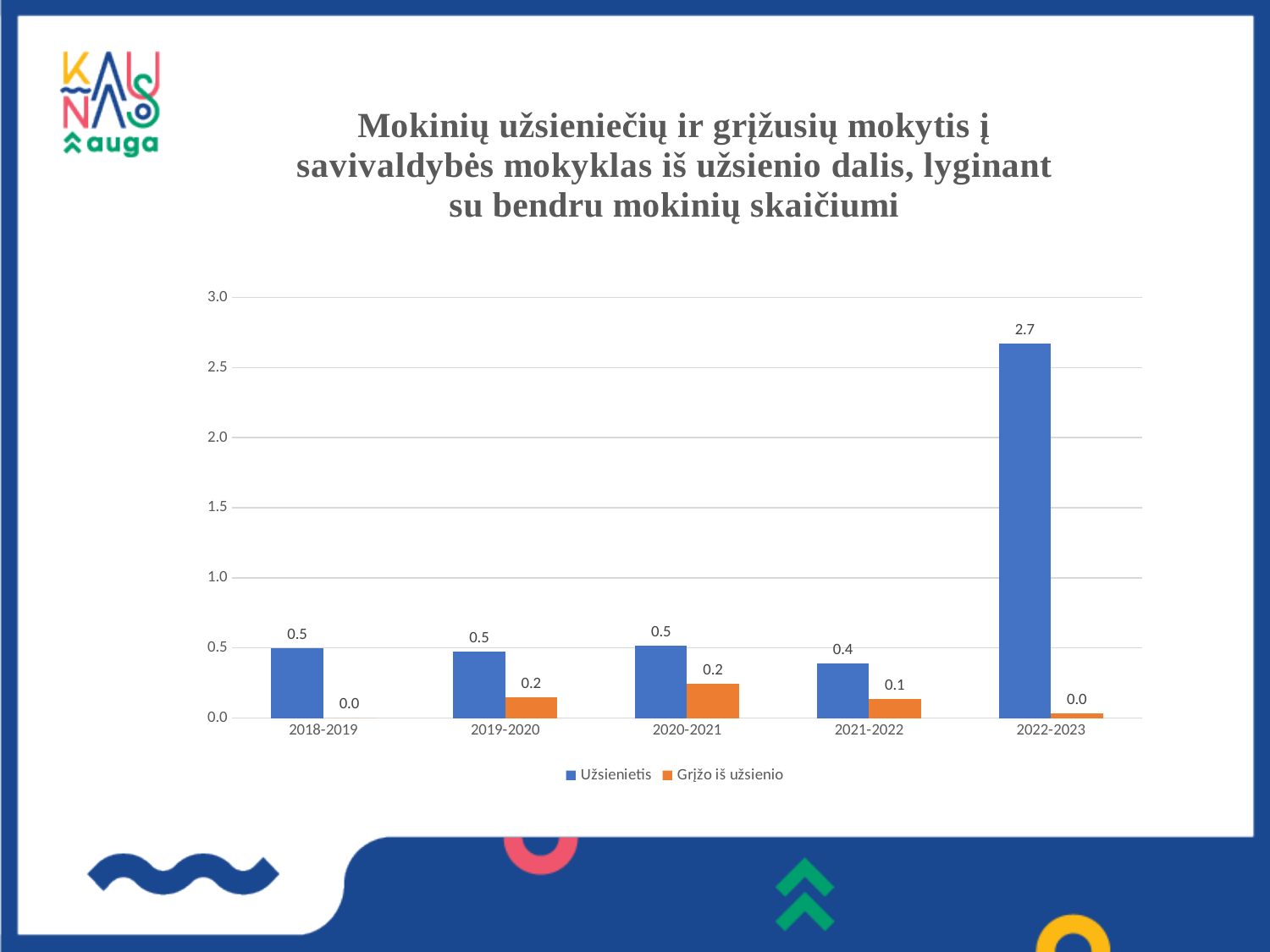
In which school year is the Užsienietis value lowest? 2021-2022 What is the value for Užsienietis in 2022-2023? 2.7 How many school years are shown on the x axis? 5 What kind of chart is shown on the slide? Bar chart What is the value for Užsienietis in 2021-2022? 0.4 In which school year is the Užsienietis value highest? 2022-2023 Which is larger in 2020-2021: the Užsienietis value or the Grįžo iš užsienio value? Užsienietis How many series does the legend list? 2 What is the value for Grįžo iš užsienio in 2019-2020? 0.2 Is the Užsienietis value for 2022-2023 greater or less than 2.5? greater What is the difference between the Užsienietis values for 2022-2023 and 2021-2022? 2.3 What is the value for Grįžo iš užsienio in 2021-2022? 0.1